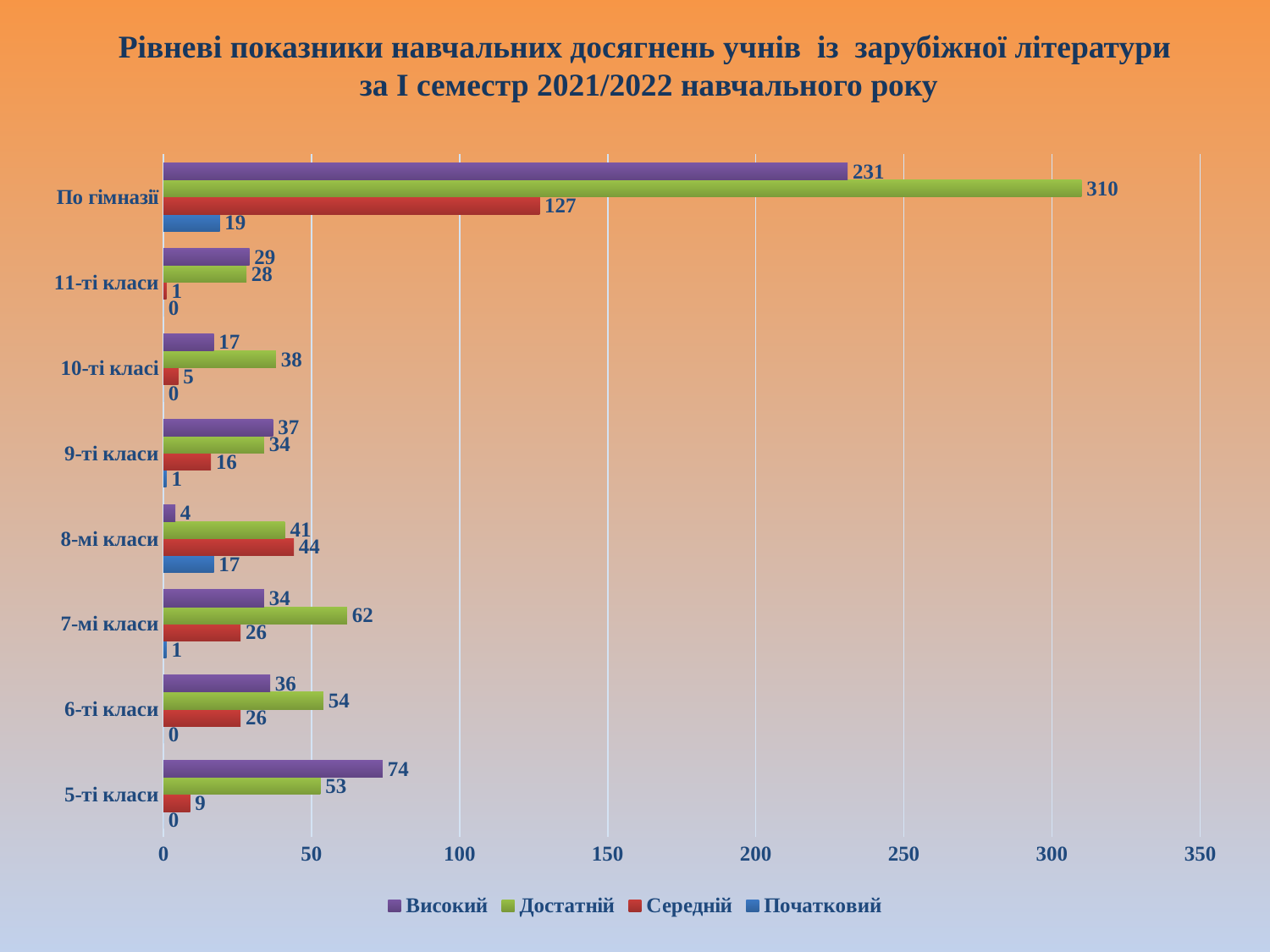
Which is larger for 7-мі класи: Достатній or Високий? Достатній What type of chart is shown on the slide? Bar chart What is the value of Високий for 5-ті класи? 74 What is the value of Середній for 8-мі класи? 44 Is the value of Високий for По гімназії greater or less than 200? greater What is the value of Достатній for По гімназії? 310 Which class group has the lowest Високий value? 8-мі класи Which class group has the highest Високий value (excluding По гімназії)? 5-ті класи How many categories are shown on the vertical axis? 8 What is the difference between the Достатній and Середній values for По гімназії? 183 How many series does the legend list? 4 What is the value of Початковий for 11-ті класи? 0